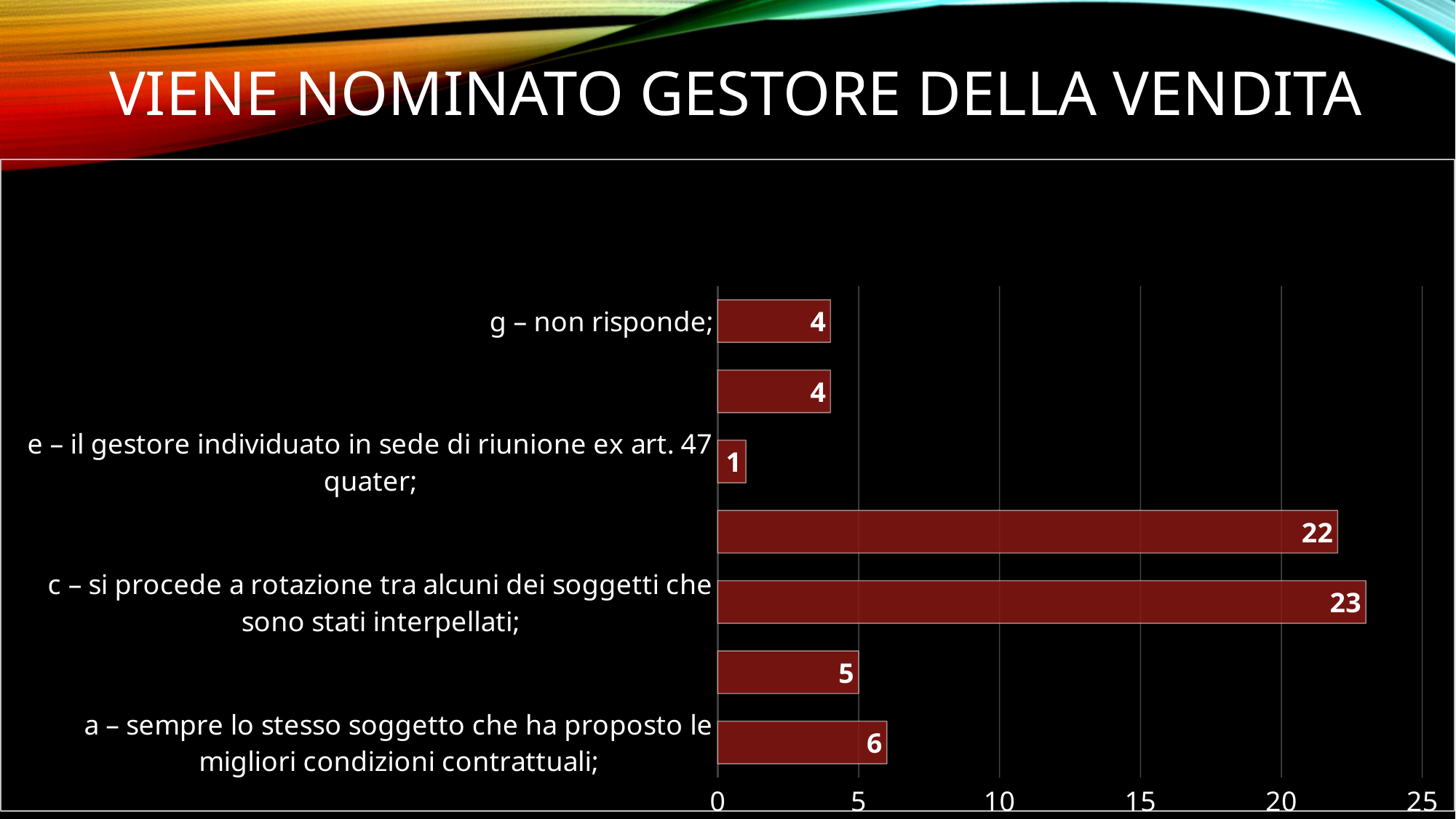
What kind of chart is shown on the slide? bar chart Which is larger: the value for 'a – sempre lo stesso soggetto che ha proposto le migliori condizioni contrattuali;' or the value for 'g – non risponde;'? a – sempre lo stesso soggetto che ha proposto le migliori condizioni contrattuali; What is the difference between the value for 'g – non risponde;' and the value for 'e – il gestore individuato in sede di riunione ex art. 47 quater;'? 3 What is the value for 'c – si procede a rotazione tra alcuni dei soggetti che sono stati interpellati;'? 23 How many bars are plotted in the chart? 7 What is the difference between the value for 'c – si procede a rotazione tra alcuni dei soggetti che sono stati interpellati;' and the value for 'a – sempre lo stesso soggetto che ha proposto le migliori condizioni contrattuali;'? 17 What is the value for 'a – sempre lo stesso soggetto che ha proposto le migliori condizioni contrattuali;'? 6 Which category has the highest value? c – si procede a rotazione tra alcuni dei soggetti che sono stati interpellati; What is the value for 'g – non risponde;'? 4 Which category has the lowest value? e – il gestore individuato in sede di riunione ex art. 47 quater; What is the value for 'e – il gestore individuato in sede di riunione ex art. 47 quater;'? 1 Is the value for 'c – si procede a rotazione tra alcuni dei soggetti che sono stati interpellati;' greater or less than 20? greater